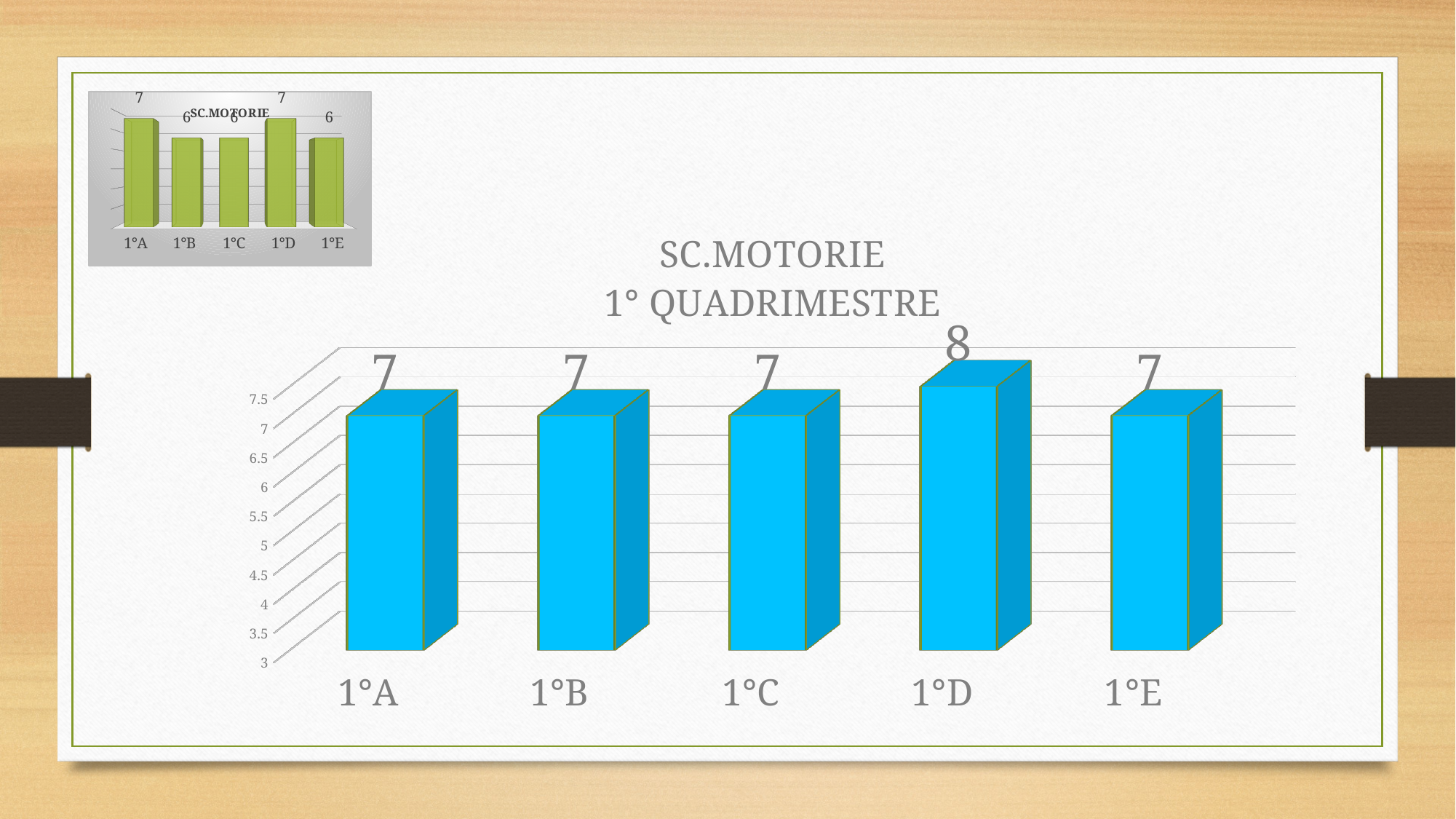
In the large chart titled SC.MOTORIE 1° QUADRIMESTRE, what is the difference between the values for 1°D and 1°E? 1 What kind of chart is the large chart titled SC.MOTORIE 1° QUADRIMESTRE? bar chart In the large chart titled SC.MOTORIE 1° QUADRIMESTRE, which category has the highest value? 1°D In the large chart titled SC.MOTORIE 1° QUADRIMESTRE, what is the value for 1°A? 7 In the large chart titled SC.MOTORIE 1° QUADRIMESTRE, what is the value for 1°D? 8 In the small chart at the top left titled SC.MOTORIE, what is the difference between the values for 1°A and 1°E? 1 In the small chart at the top left titled SC.MOTORIE, what is the value for 1°B? 6 In the small chart at the top left titled SC.MOTORIE, what is the value for 1°D? 7 In the small chart at the top left titled SC.MOTORIE, which is larger, the value for 1°A or the value for 1°C? 1°A What is the title of the large chart on the slide? SC.MOTORIE 1° QUADRIMESTRE In the large chart titled SC.MOTORIE 1° QUADRIMESTRE, how many categories are shown on the x axis? 5 In the large chart titled SC.MOTORIE 1° QUADRIMESTRE, which is larger, the value for 1°D or the value for 1°B? 1°D